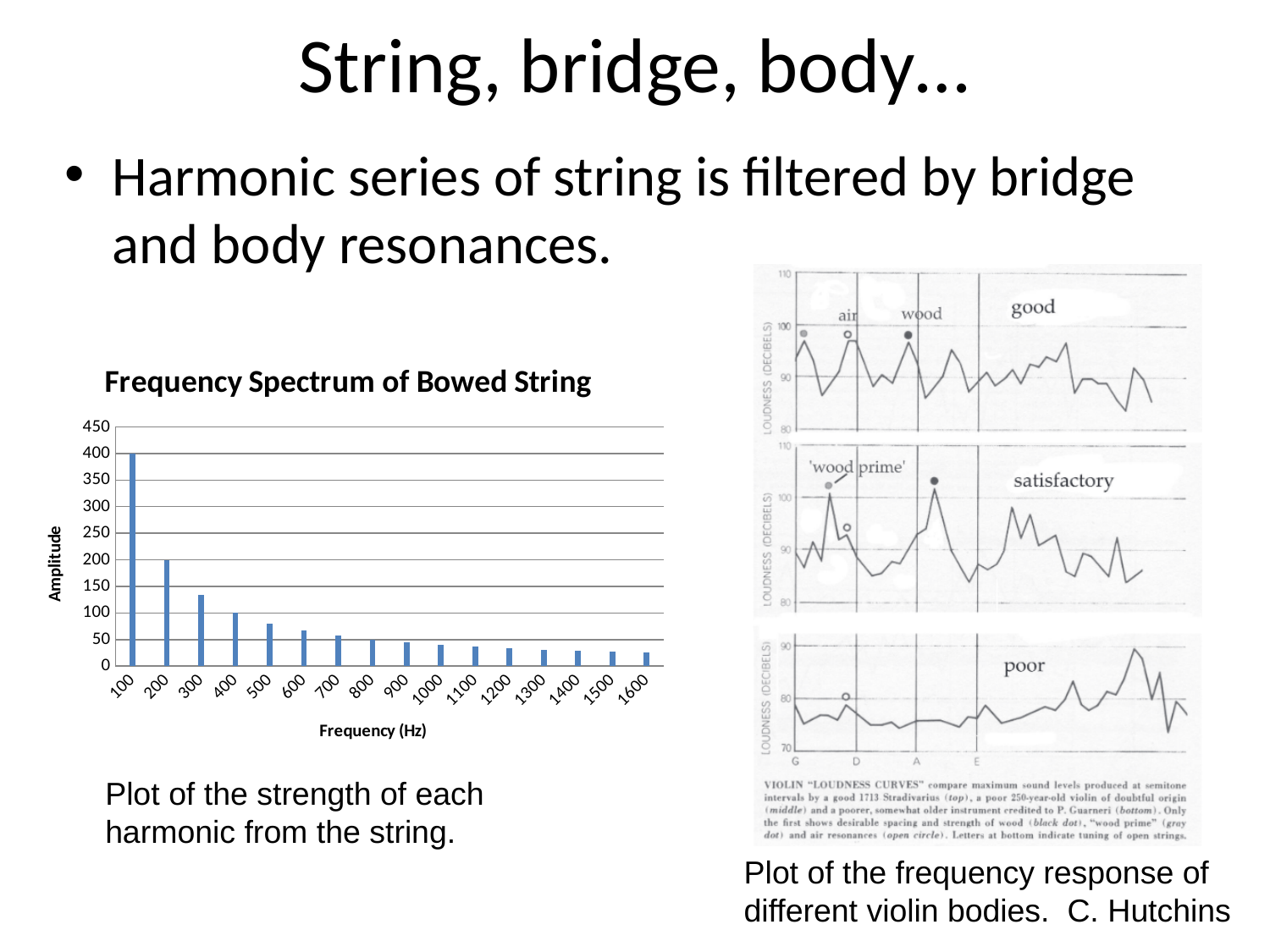
In the Frequency Spectrum of Bowed String chart, how many frequency bars are plotted? 16 In the Frequency Spectrum of Bowed String chart, what is the difference in amplitude between 100 Hz and 200 Hz? 200 In the Frequency Spectrum of Bowed String chart, which frequency has the highest amplitude? 100 In the Frequency Spectrum of Bowed String chart, which frequency has the lowest amplitude? 1600 In the Frequency Spectrum of Bowed String chart, what is the label of the vertical axis? Amplitude In the Frequency Spectrum of Bowed String chart, what is the amplitude at 200 Hz? 200 In the Frequency Spectrum of Bowed String chart, is the amplitude at 500 Hz greater or less than 100? less In the Frequency Spectrum of Bowed String chart, which has the larger amplitude, 300 Hz or 400 Hz? 300 Hz In the Frequency Spectrum of Bowed String chart, do the amplitudes rise or fall as frequency increases? fall In the Frequency Spectrum of Bowed String chart, is the amplitude at 300 Hz greater or less than 100? greater In the Frequency Spectrum of Bowed String chart, what is the amplitude at 100 Hz? 400 In the Frequency Spectrum of Bowed String chart, what kind of chart is shown? bar chart